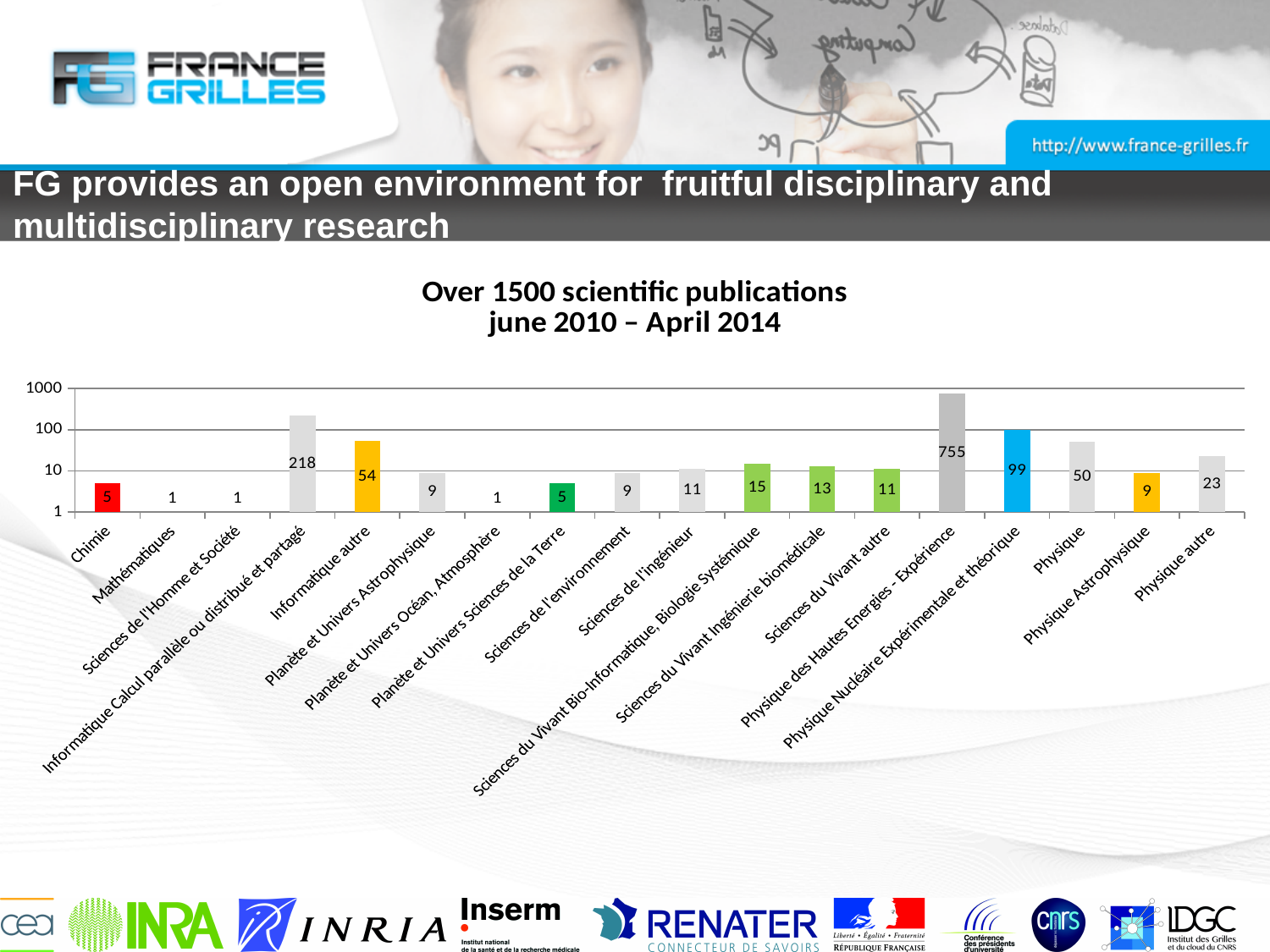
What is the value for Informatique Calcul parallèle ou distribué et partagé? 218 How many categories are shown on the x axis? 18 Which category has the highest value? Physique des Hautes Energies - Expérience Which is larger, the value for Physique autre or the value for Sciences du Vivant Ingénierie biomédicale? Physique autre What is the value for Sciences du Vivant Bio-Informatique, Biologie Systémique? 15 What is the value for Physique des Hautes Energies - Expérience? 755 What is the difference between the values for Physique des Hautes Energies - Expérience and Informatique Calcul parallèle ou distribué et partagé? 537 What is the title of the chart? Over 1500 scientific publications june 2010 – April 2014 What kind of chart is shown on the slide? Bar chart What is the value for Physique Nucléaire Expérimentale et théorique? 99 What is the difference between the values for Informatique autre and Physique? 4 What is the lowest value shown on the chart? 1